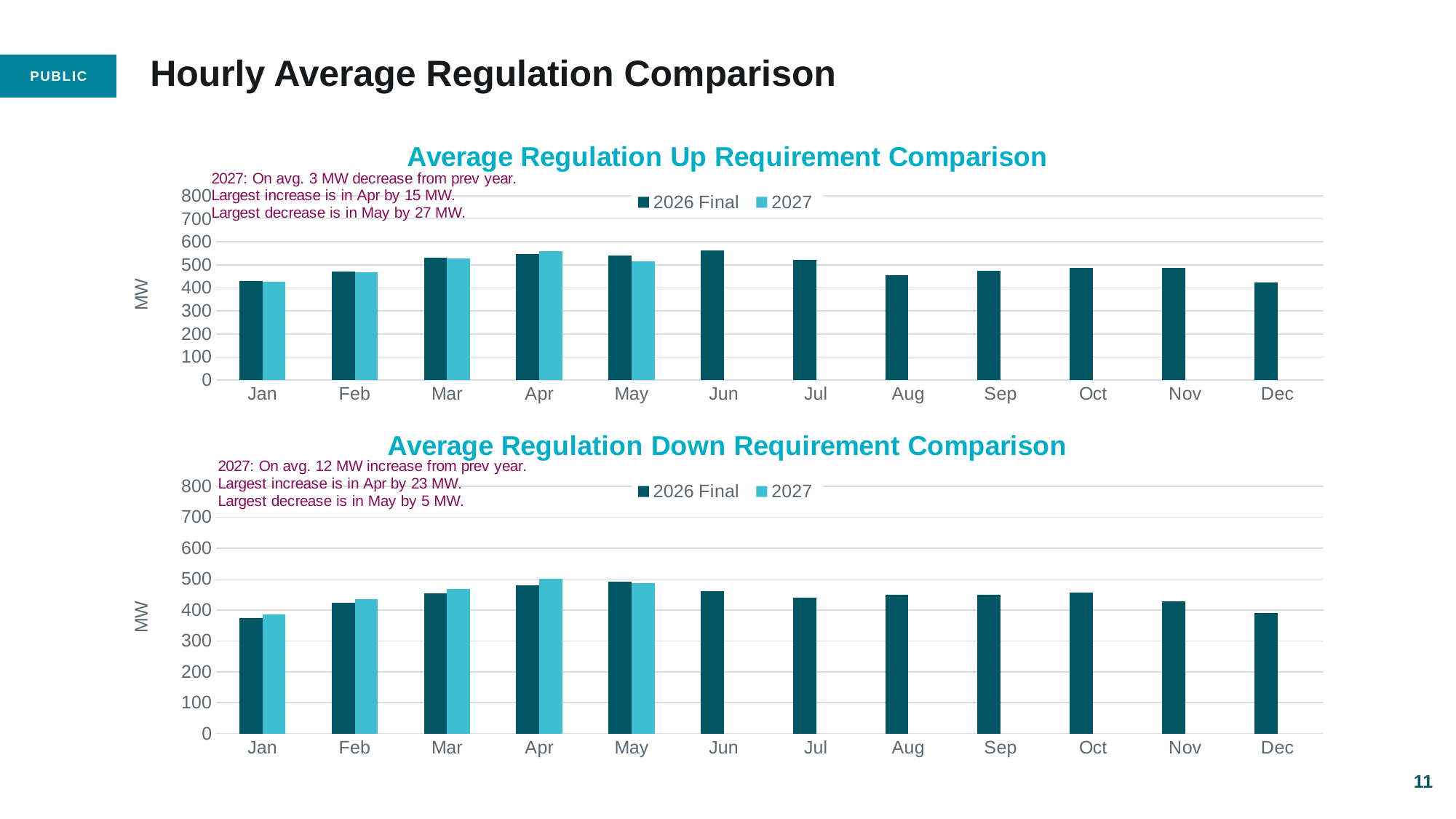
In the Average Regulation Up Requirement Comparison chart, which month has the highest 2026 Final value? Jun What is the y-axis label of the Average Regulation Down Requirement Comparison chart? MW In the Average Regulation Down Requirement Comparison chart, do the 2026 Final values rise or fall from Jan to Apr? rise How many months are shown on the x axis of the Average Regulation Up Requirement Comparison chart? 12 In the Average Regulation Up Requirement Comparison chart, which is larger for May: 2026 Final or 2027? 2026 Final What are the two legend entries in the Average Regulation Up Requirement Comparison chart? 2026 Final and 2027 What kind of chart is the Average Regulation Up Requirement Comparison chart? bar chart In the Average Regulation Down Requirement Comparison chart, is the 2026 Final value for Jan greater or less than 400? less In the Average Regulation Down Requirement Comparison chart, which is larger for Apr: 2026 Final or 2027? 2027 In the Average Regulation Up Requirement Comparison chart, is the 2026 Final value for Dec greater or less than 500? less How many series does the legend of the Average Regulation Down Requirement Comparison chart list? 2 In the Average Regulation Up Requirement Comparison chart, is the 2026 Final value for Jun greater or less than 500? greater